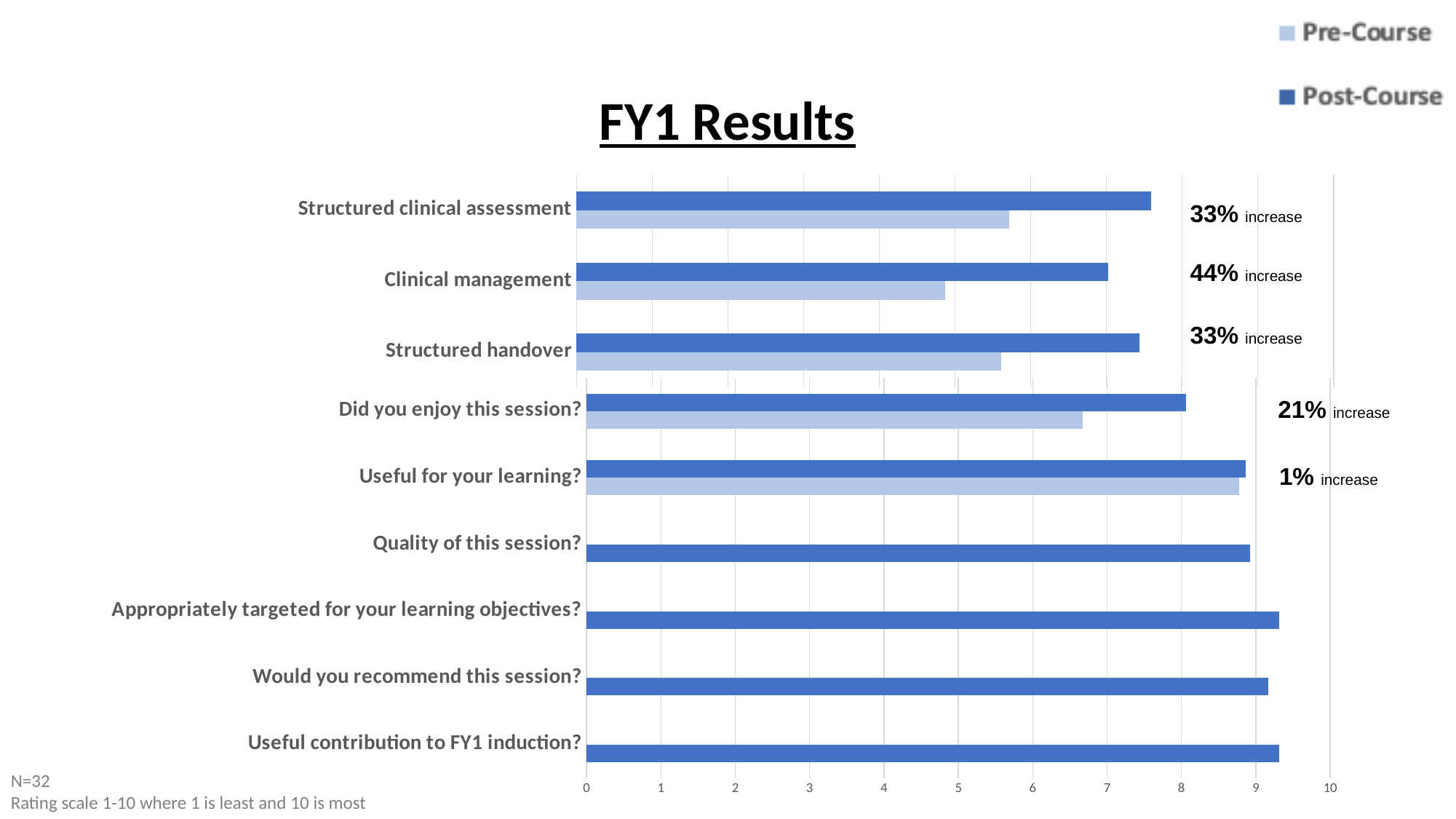
How many series does the legend list? 2 What percentage increase is shown for 'Did you enjoy this session?' 21% increase For Clinical management, which is larger, the Pre-Course or the Post-Course value? Post-Course Is the Post-Course value for Structured clinical assessment greater or less than 7? greater What is the title of the chart? FY1 Results What percentage increase is shown for 'Useful for your learning?' 1% increase What percentage increase is shown for Clinical management? 44% increase How many categories are shown on the chart? 9 Which category has the lowest Pre-Course value? Clinical management Is the Pre-Course value for Clinical management greater or less than 5? less What kind of chart is shown on the slide? bar chart Is the Post-Course value for 'Appropriately targeted for your learning objectives?' greater or less than 9? greater